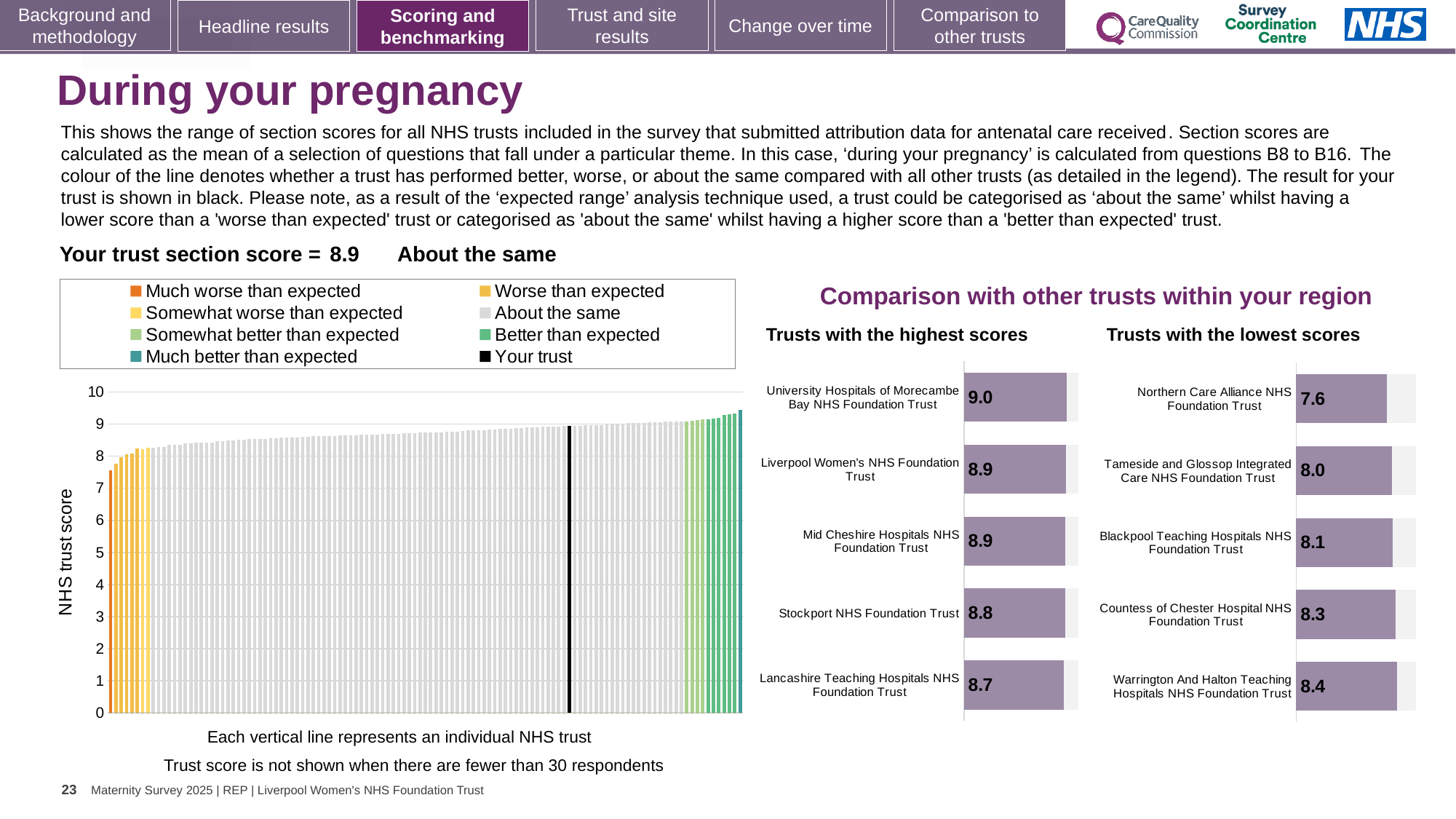
In the 'Trusts with the lowest scores' chart, what is the difference between the scores of Warrington And Halton Teaching Hospitals NHS Foundation Trust and Northern Care Alliance NHS Foundation Trust? 0.8 In the 'Trusts with the lowest scores' chart, what is the score for Northern Care Alliance NHS Foundation Trust? 7.6 What kind of chart is the 'Trusts with the highest scores' chart? Bar chart In the 'Trusts with the highest scores' chart, what is the difference between the scores of University Hospitals of Morecambe Bay NHS Foundation Trust and Stockport NHS Foundation Trust? 0.2 How many trusts are listed in the 'Trusts with the highest scores' chart? 5 In the 'Trusts with the highest scores' chart, which trust has the lowest score? Lancashire Teaching Hospitals NHS Foundation Trust In the main 'NHS trust score' chart on the left, is the value for the black 'Your trust' bar greater or less than 8? greater In the 'Trusts with the lowest scores' chart, which has the larger score: Tameside and Glossop Integrated Care NHS Foundation Trust or Blackpool Teaching Hospitals NHS Foundation Trust? Blackpool Teaching Hospitals NHS Foundation Trust How many entries does the legend of the main 'NHS trust score' chart on the left list? 8 In the 'Trusts with the lowest scores' chart, which trust has the highest score? Warrington And Halton Teaching Hospitals NHS Foundation Trust In the 'Trusts with the highest scores' chart, what is the score for University Hospitals of Morecambe Bay NHS Foundation Trust? 9.0 In the 'Trusts with the lowest scores' chart, what is the score for Countess of Chester Hospital NHS Foundation Trust? 8.3